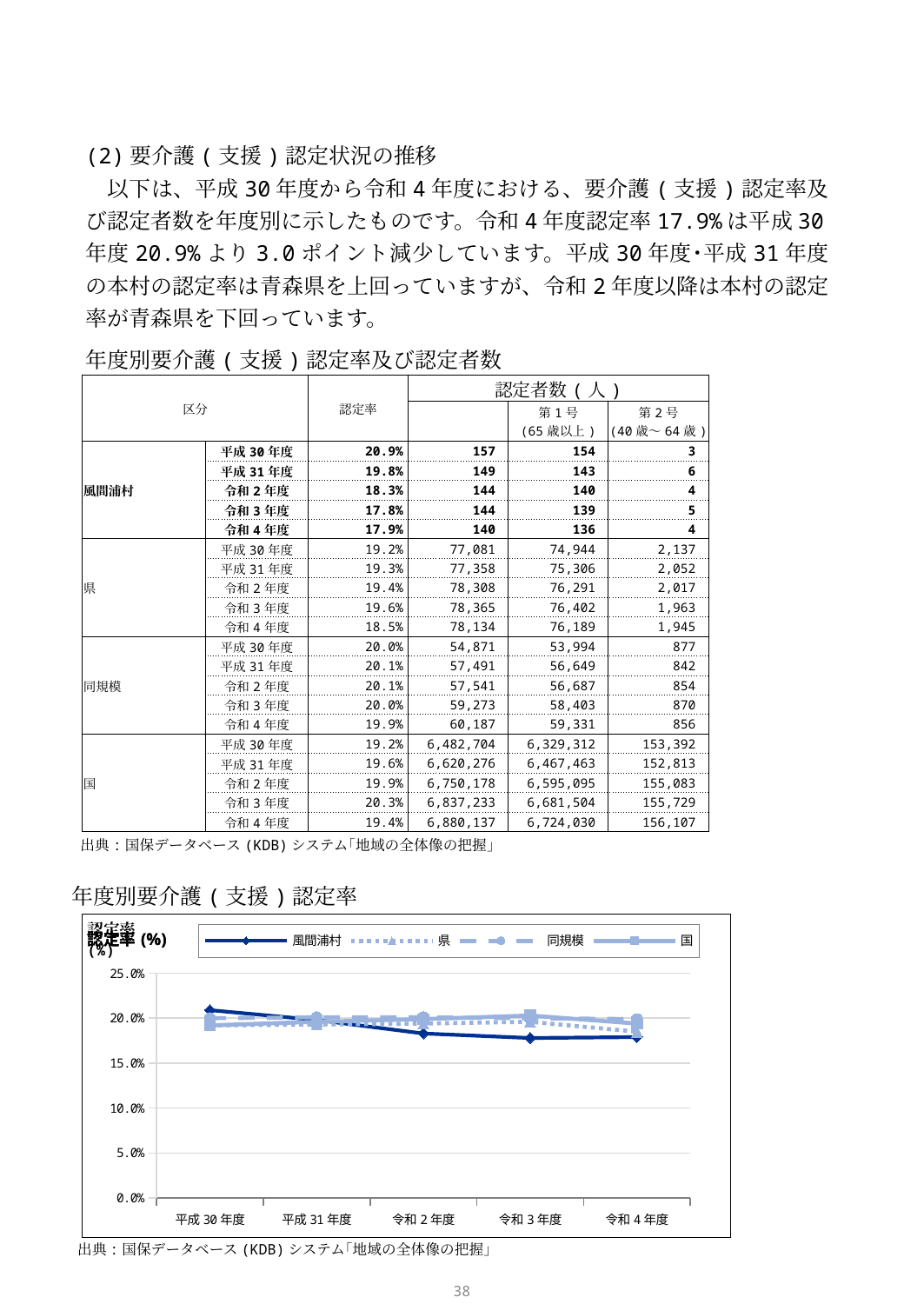
How many fiscal years are plotted along the x axis of the 年度別要介護（支援）認定率 chart? 5 By how many percentage points did the 風間浦村 認定率 fall from 平成30年度 (20.9%) to 令和4年度 (17.9%)? 3.0 What kind of chart is the 年度別要介護（支援）認定率 chart? line chart What is the label of the y axis of the 年度別要介護（支援）認定率 chart? 認定率 (%) What is the 認定率 of 風間浦村 for 平成30年度 as shown in the table? 20.9% In the 年度別要介護（支援）認定率 chart, does the 風間浦村 line rise or fall from 平成30年度 to 令和4年度? fall How many series does the legend of the 年度別要介護（支援）認定率 chart list? 4 In the 年度別要介護（支援）認定率 chart, which series has the highest value in 平成30年度? 風間浦村 What is the 認定率 of 風間浦村 for 令和4年度 as shown in the table? 17.9% In the 年度別要介護（支援）認定率 chart, is the 風間浦村 value for 平成30年度 greater or less than 20.0%? greater In the 年度別要介護（支援）認定率 chart, which is larger in 令和4年度, 風間浦村 or 同規模? 同規模 In the 年度別要介護（支援）認定率 chart, is the 風間浦村 value for 令和4年度 greater or less than 20.0%? less